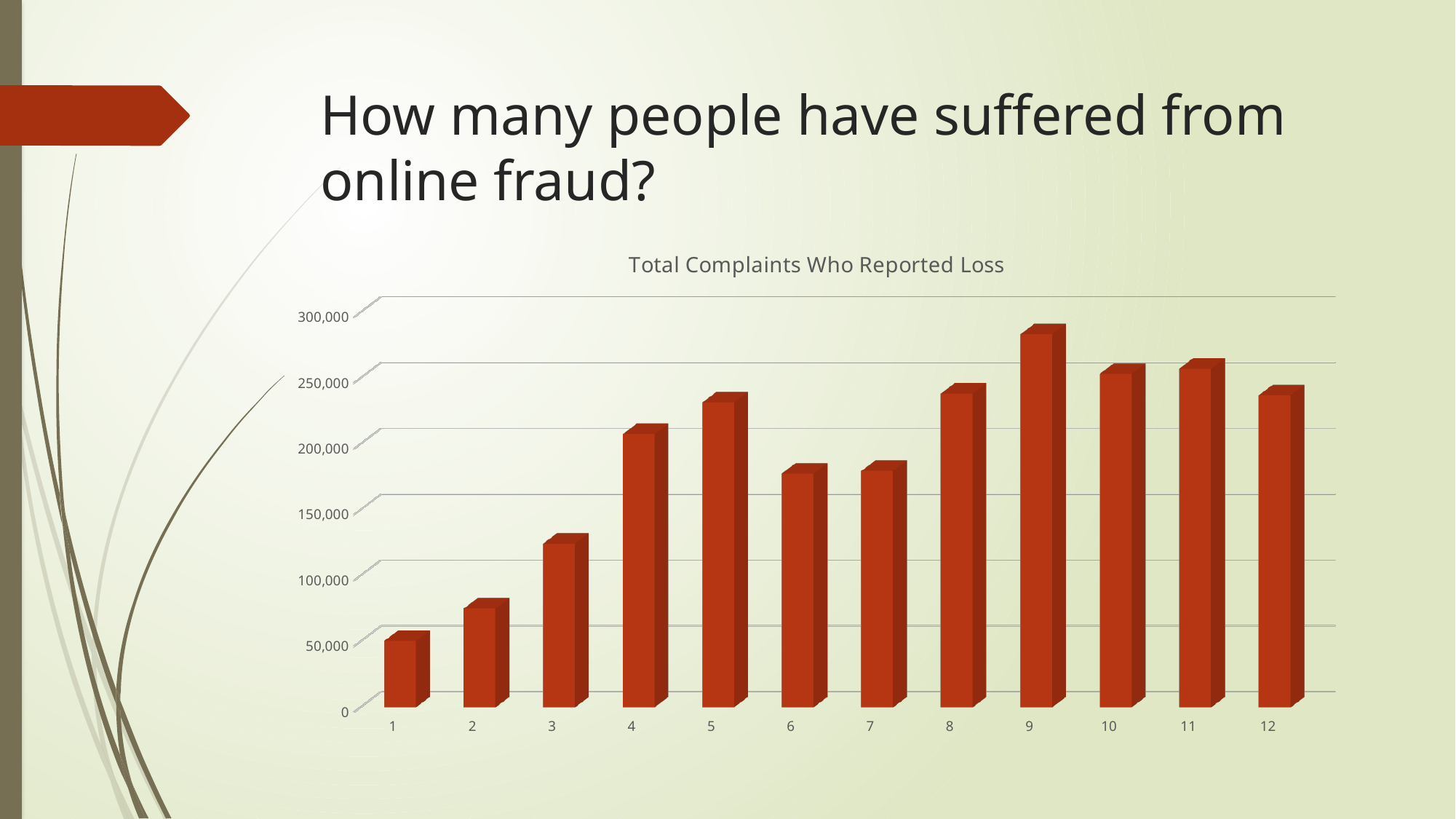
What is the title of the chart? Total Complaints Who Reported Loss What kind of chart is shown on the slide? bar chart Do the values rise or fall from category 1 to category 5? rise How many categories are shown on the x axis of the chart? 12 Which has the larger value, category 9 or category 12? 9 Which category has the lowest value in the chart? 1 Which category has the highest value in the chart? 9 Is the value for category 6 greater or less than 200,000? less Which has the larger value, category 4 or category 3? 4 Is the value for category 3 greater or less than 100,000? greater Is the value for category 9 greater or less than 250,000? greater